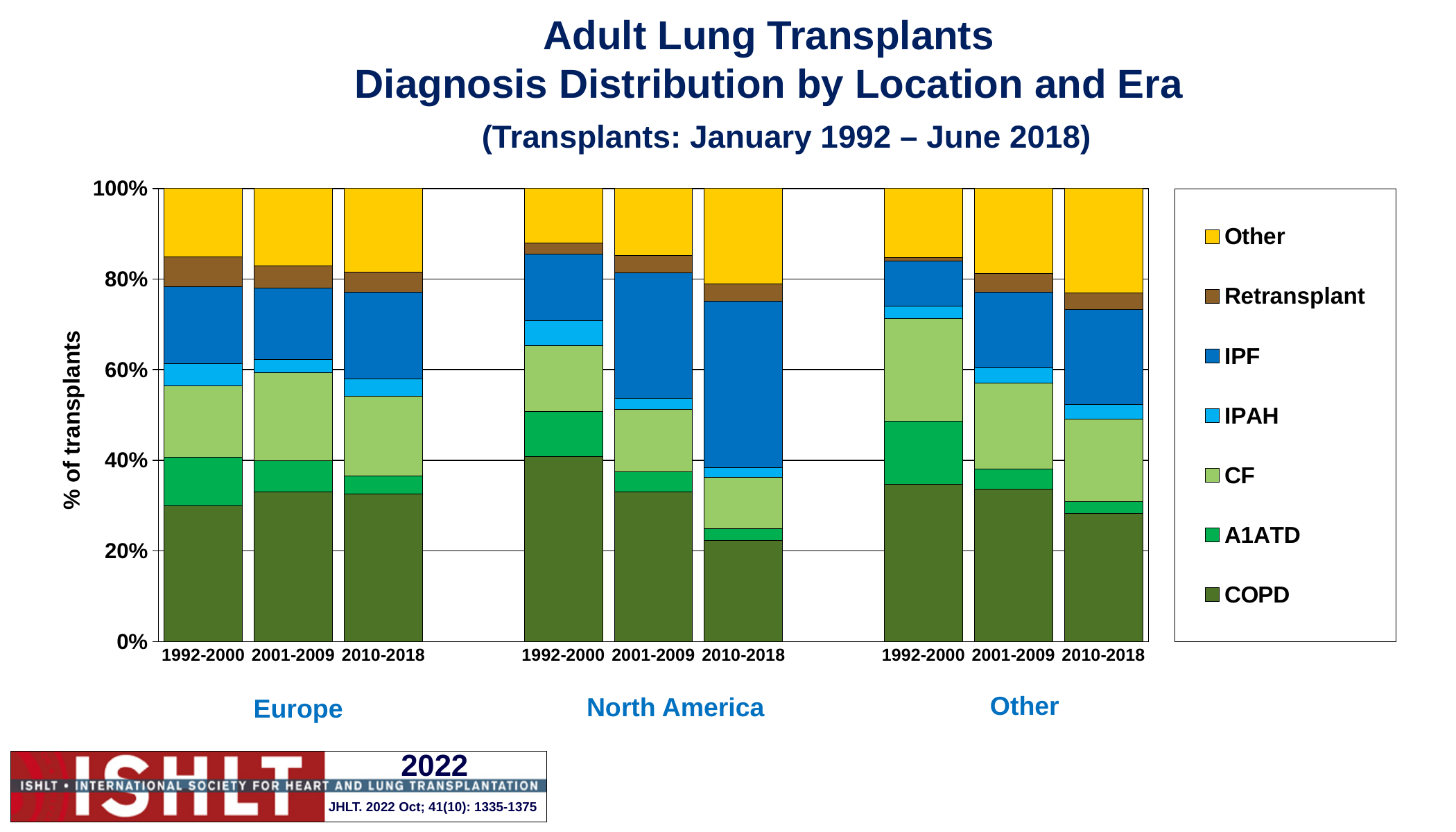
How many regions are shown along the x axis? 3 What kind of chart is shown on the slide? Stacked bar chart How many bars are plotted in the chart? 9 Is the COPD share for Europe 1992-2000 greater or less than 40%? less Which legend entry is shown in yellow? Other How many series does the legend list? 7 Does the COPD share in North America rise or fall from 1992-2000 to 2010-2018? fall Which has the larger COPD share: North America 1992-2000 or North America 2010-2018? North America 1992-2000 What is the label of the y axis? % of transplants Is the COPD share for North America 2010-2018 greater or less than 40%? less Is the COPD share for North America 1992-2000 greater or less than 20%? greater Which has the larger IPF share: North America 2010-2018 or Europe 2010-2018? North America 2010-2018